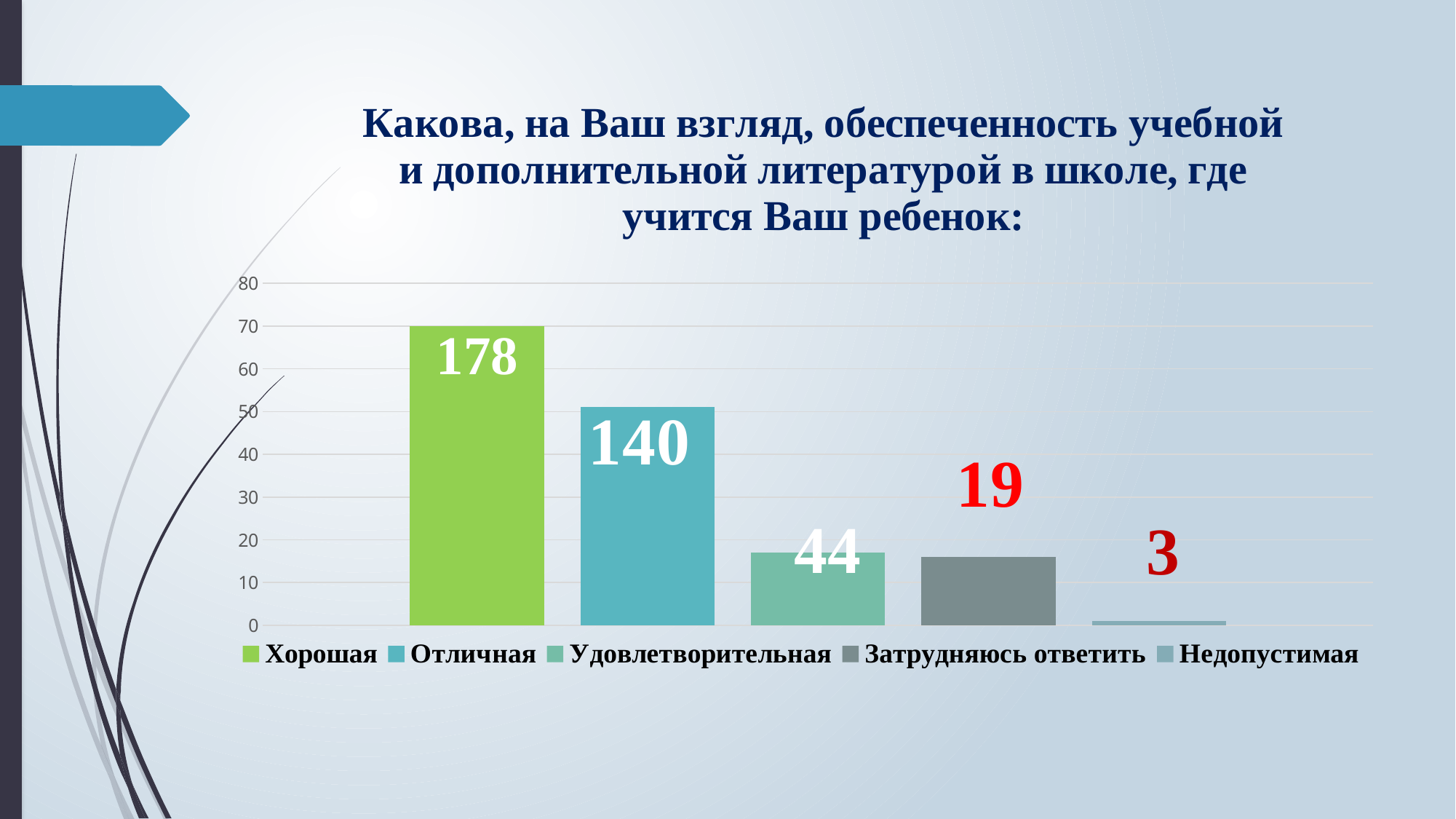
What colour is the bar for Хорошая? Green What kind of chart is shown on the slide? Bar chart Which is larger, the value for Удовлетворительная or the value for Затрудняюсь ответить? Удовлетворительная What value is shown for the category Удовлетворительная? 44 What value is shown for the category Отличная? 140 What value is shown for the category Недопустимая? 3 Which category has the highest value? Хорошая What value is shown for the category Хорошая? 178 What value is shown for the category Затрудняюсь ответить? 19 Which category has the lowest value? Недопустимая How many categories are shown in the chart? 5 What is the difference between the values for Хорошая and Отличная? 38